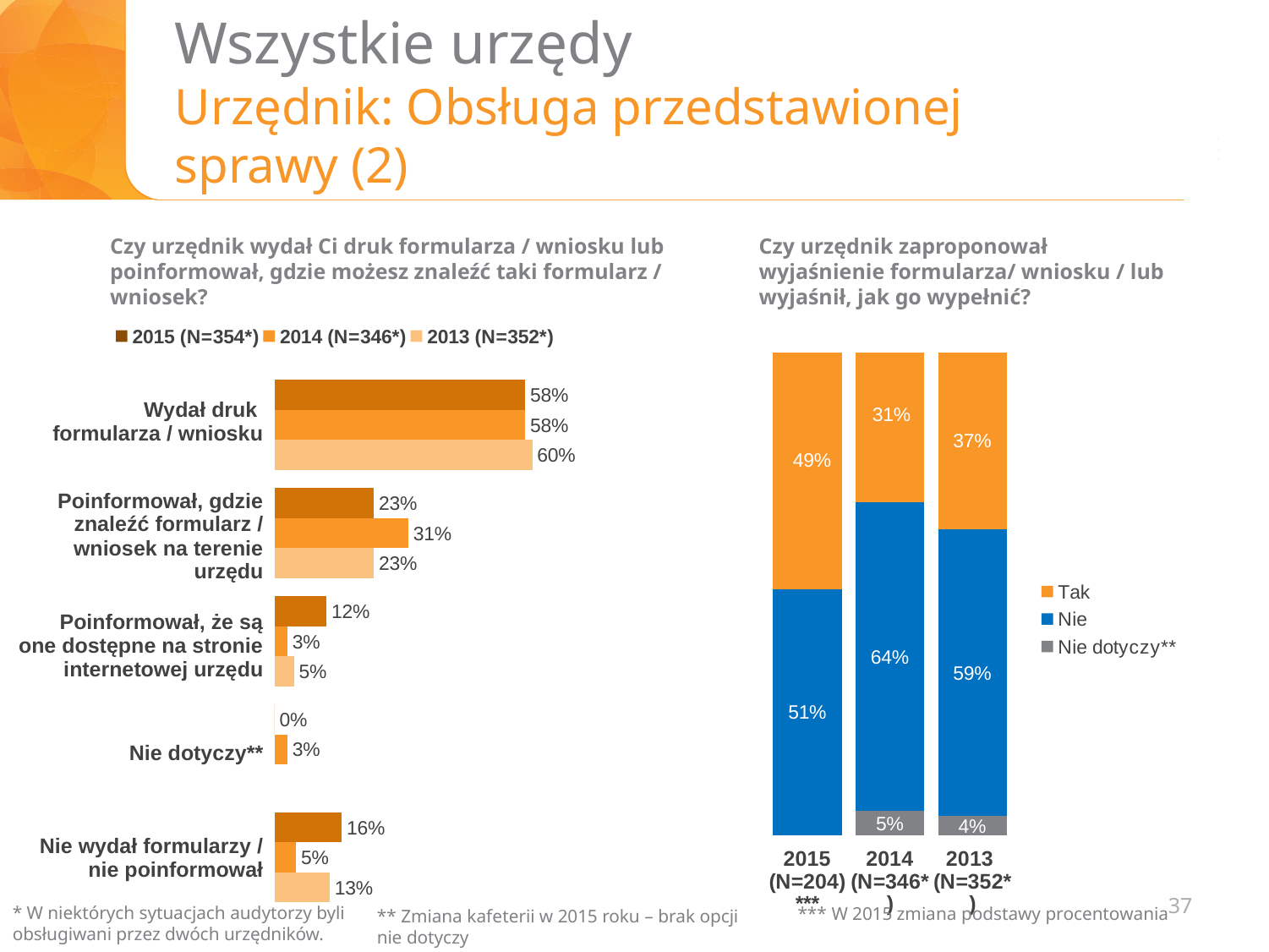
On the left chart, how many series does the legend list? 3 On the left chart, what is the 2013 value for "Nie wydał formularzy / nie poinformował"? 13% On the right chart, what is the total of the 2013 stacked bar? 100% What type of chart is the left chart? Bar chart On the left chart, which category has the highest 2015 value? Wydał druk formularza / wniosku On the left chart, which is larger for "Nie wydał formularzy / nie poinformował": the 2015 value or the 2014 value? 2015 On the right chart, which year has the highest "Nie" value? 2014 On the left chart, what is the difference between the 2015 and 2014 values for "Poinformował, że są one dostępne na stronie internetowej urzędu"? 9 percentage points On the right chart, what is the "Tak" value for 2015? 49% On the left chart, what is the 2014 value for "Poinformował, gdzie znaleźć formularz / wniosek na terenie urzędu"? 31% On the left chart, what is the 2015 value for "Wydał druk formularza / wniosku"? 58% On the right chart, what is the "Nie" value for 2014? 64%